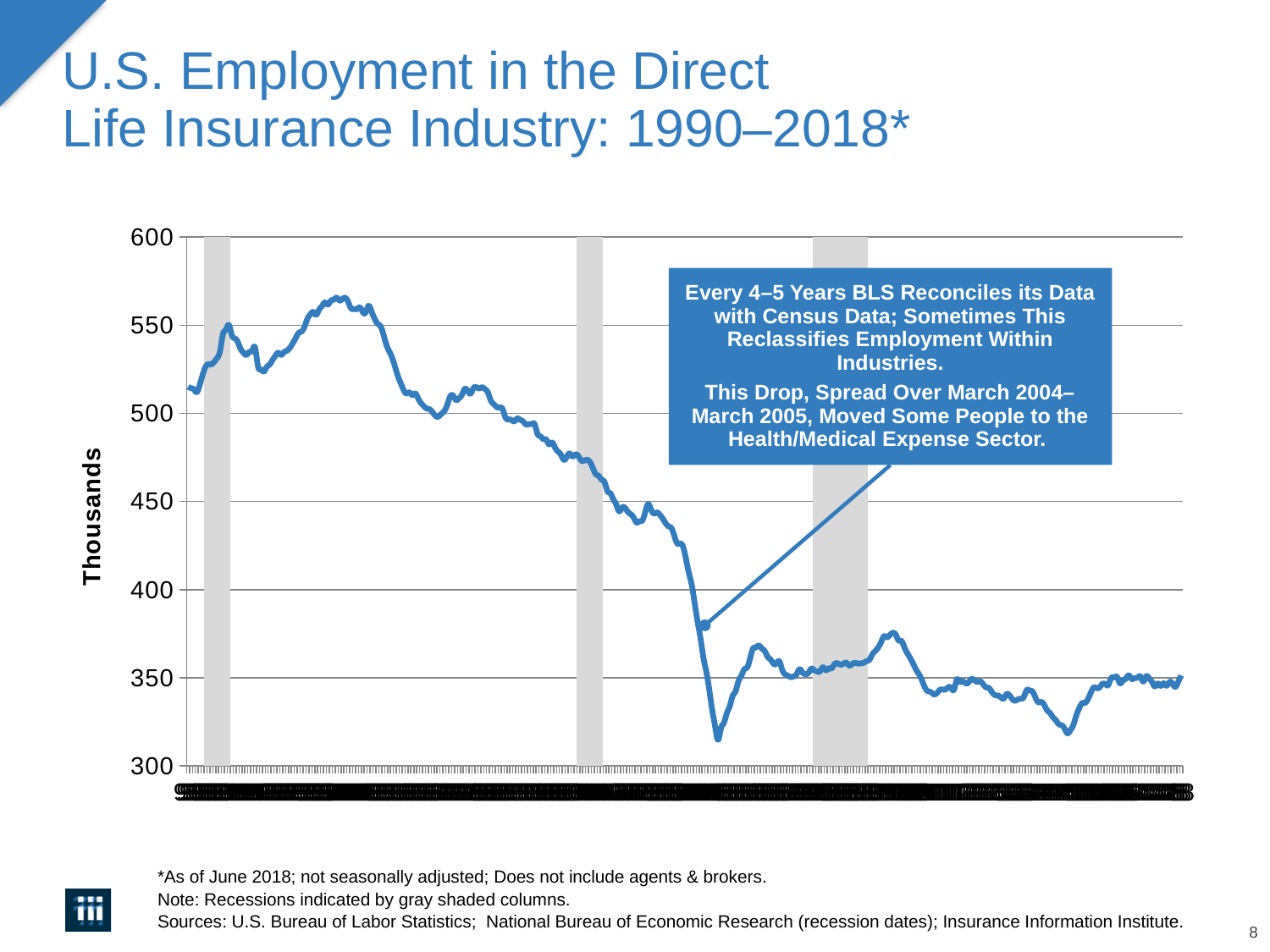
Is the value at the start of the series (1990) greater or less than 500? greater Overall, do the values rise or fall from the start of the series in 1990 to the end in 2018? fall Is the highest point on the line greater or less than 550? greater How many gray shaded recession columns are shown on the chart? 3 Is the value at the end of the series (June 2018) greater or less than 400? less What is the label on the vertical axis? Thousands What kind of chart is shown on the slide? line chart Is the value at the start of the series (1990) larger or smaller than the value at the end of the series (2018)? larger